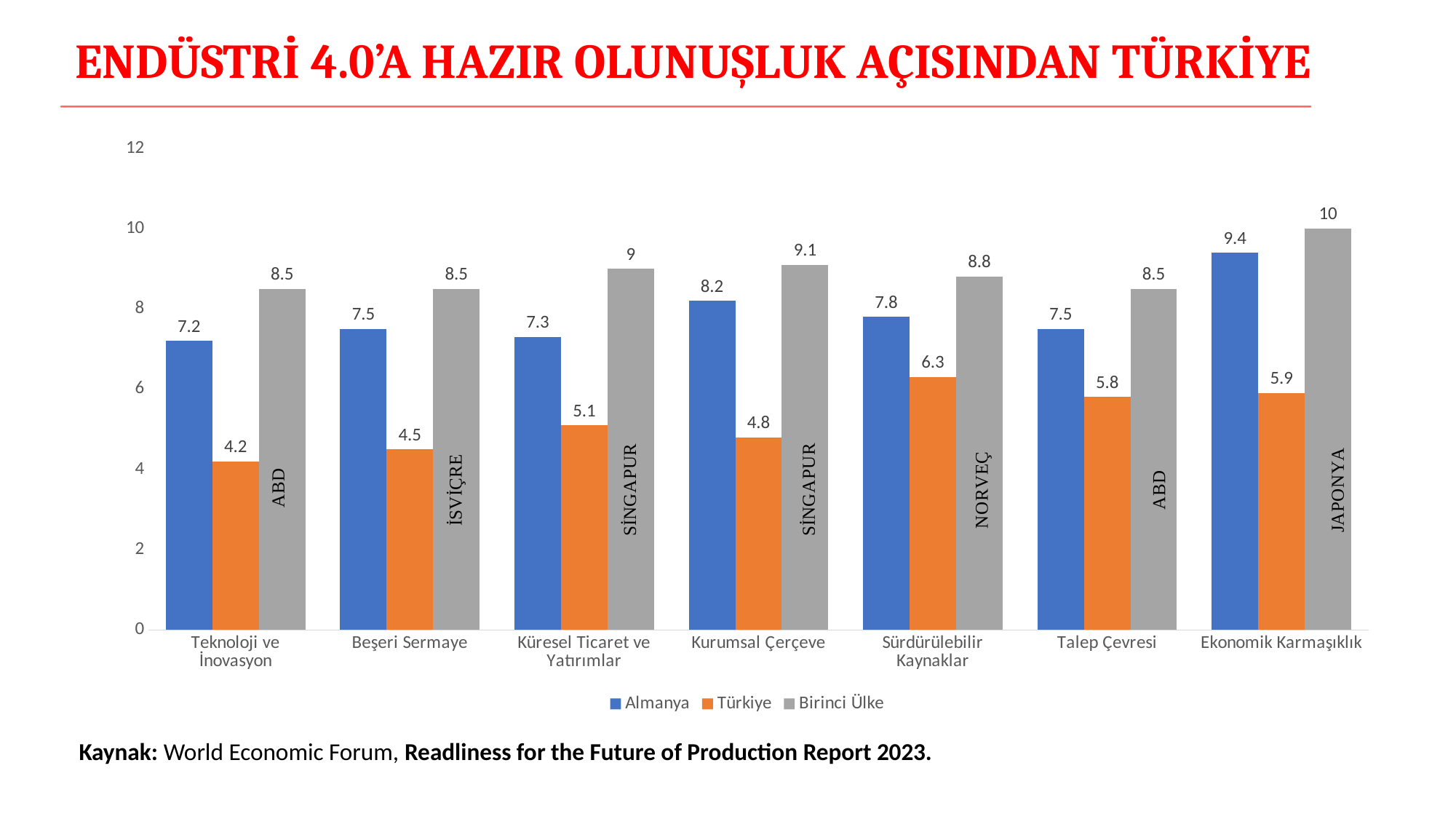
In which category does Almanya have its lowest value? Teknoloji ve İnovasyon How many series does the legend list? 3 In which category does Türkiye have its highest value? Sürdürülebilir Kaynaklar What is the value for Birinci Ülke in the Ekonomik Karmaşıklık category? 10 How many categories are shown on the x axis? 7 What is the difference between the Birinci Ülke value and the Türkiye value in the Küresel Ticaret ve Yatırımlar category? 3.9 Is the value for Almanya in the Ekonomik Karmaşıklık category greater or less than 8? greater What kind of chart is shown on the slide? Bar chart Which is larger: the Türkiye value for Talep Çevresi or the Türkiye value for Ekonomik Karmaşıklık? Ekonomik Karmaşıklık What is the value for Almanya in the Kurumsal Çerçeve category? 8.2 Which country is labelled as the Birinci Ülke for the Sürdürülebilir Kaynaklar category? NORVEÇ What is the value for Türkiye in the Teknoloji ve İnovasyon category? 4.2